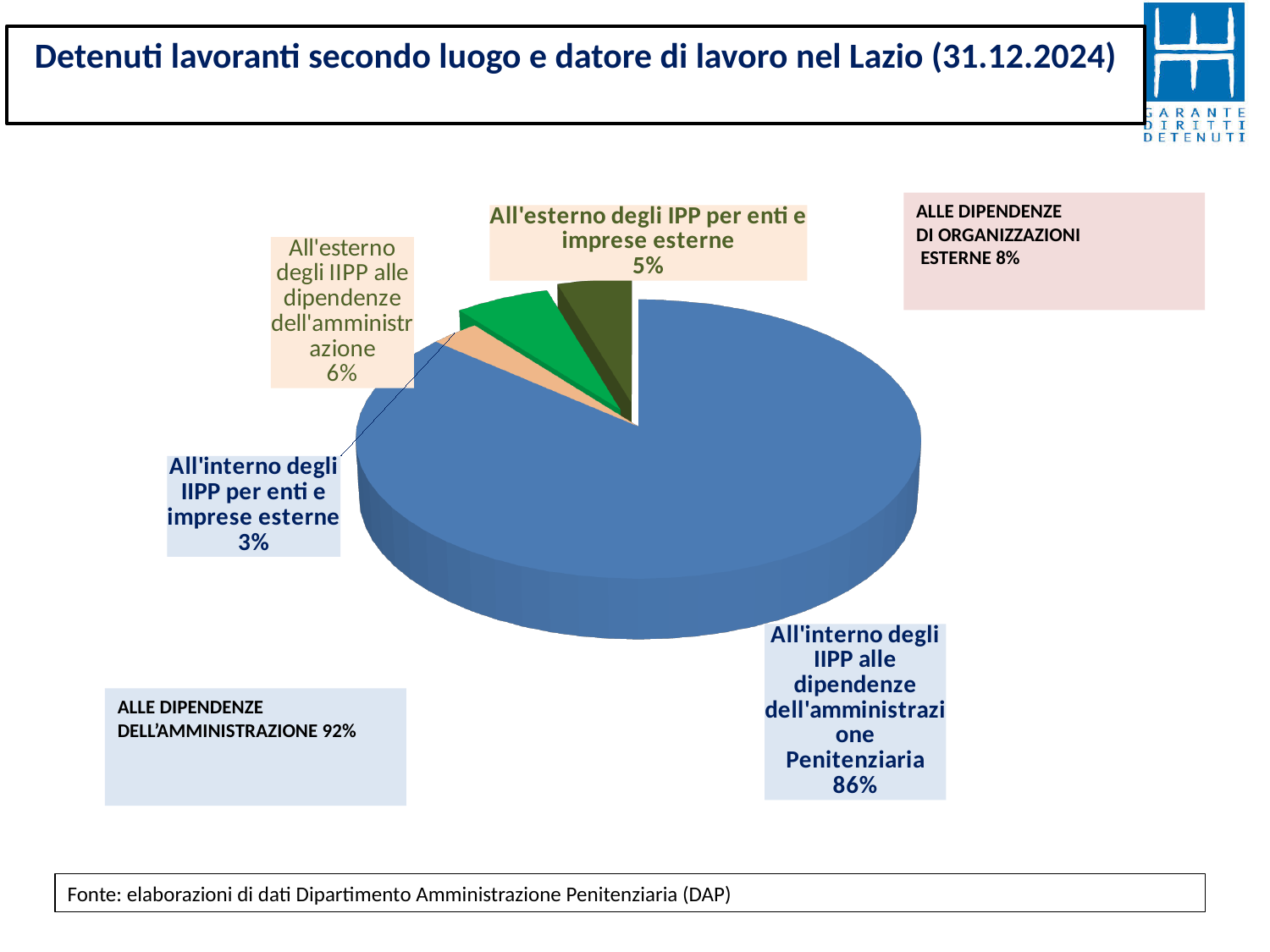
What kind of chart is shown on the slide? Pie chart How many slices does the pie chart have? 4 What is the difference in percentage points between the "All'esterno degli IIPP alle dipendenze dell'amministrazione" slice (6%) and the "All'interno degli IIPP per enti e imprese esterne" slice (3%)? 3 percentage points What share of the pie is labelled "All'interno degli IIPP alle dipendenze dell'amministrazione Penitenziaria"? 86% What share of the pie is labelled "All'esterno degli IPP per enti e imprese esterne"? 5% What share of the pie is labelled "All'interno degli IIPP per enti e imprese esterne"? 3% Which slice of the pie is the largest? All'interno degli IIPP alle dipendenze dell'amministrazione Penitenziaria What is the title of the slide containing the pie chart? Detenuti lavoranti secondo luogo e datore di lavoro nel Lazio (31.12.2024) Which slice of the pie is the smallest? All'interno degli IIPP per enti e imprese esterne Which is larger: the share for "All'esterno degli IIPP alle dipendenze dell'amministrazione" or the share for "All'esterno degli IPP per enti e imprese esterne"? All'esterno degli IIPP alle dipendenze dell'amministrazione According to the summary box on the slide, what percentage of working detainees are "alle dipendenze dell'amministrazione"? 92%